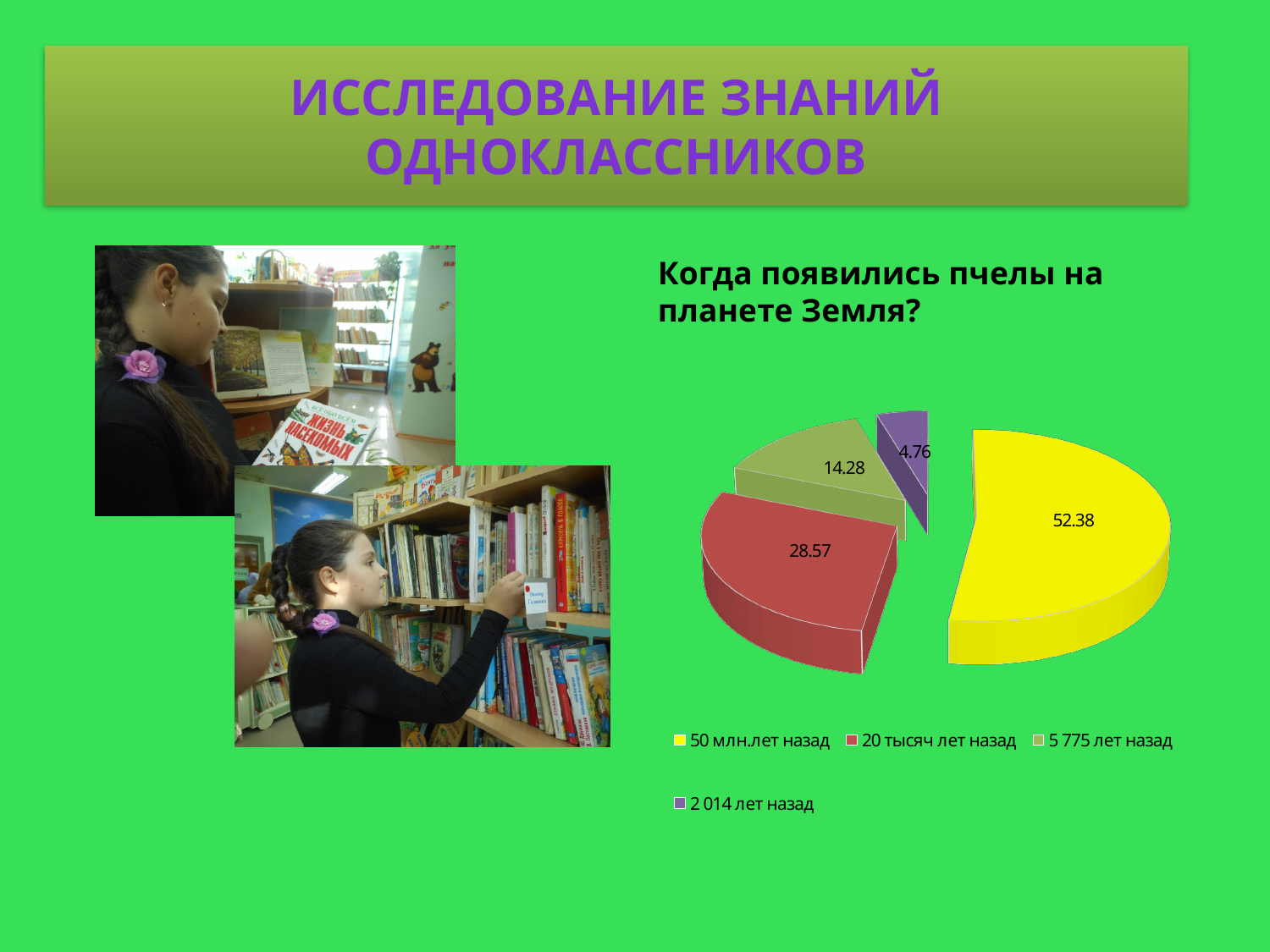
How many slices does the pie chart have? 4 What is the value for "50 млн.лет назад" in the pie chart? 52.38 Which category has the smallest slice in the pie chart? 2 014 лет назад What is the title of the pie chart? Когда появились пчелы на планете Земля? What is the value for "5 775 лет назад" in the pie chart? 14.28 Which is larger: the value for "5 775 лет назад" or the value for "2 014 лет назад"? 5 775 лет назад What colour is the slice for "20 тысяч лет назад" in the pie chart? Red What is the value for "20 тысяч лет назад" in the pie chart? 28.57 What is the value for "2 014 лет назад" in the pie chart? 4.76 What kind of chart is shown on the slide? Pie chart What is the difference between the values for "50 млн.лет назад" and "20 тысяч лет назад"? 23.81 Which category has the largest slice in the pie chart? 50 млн.лет назад